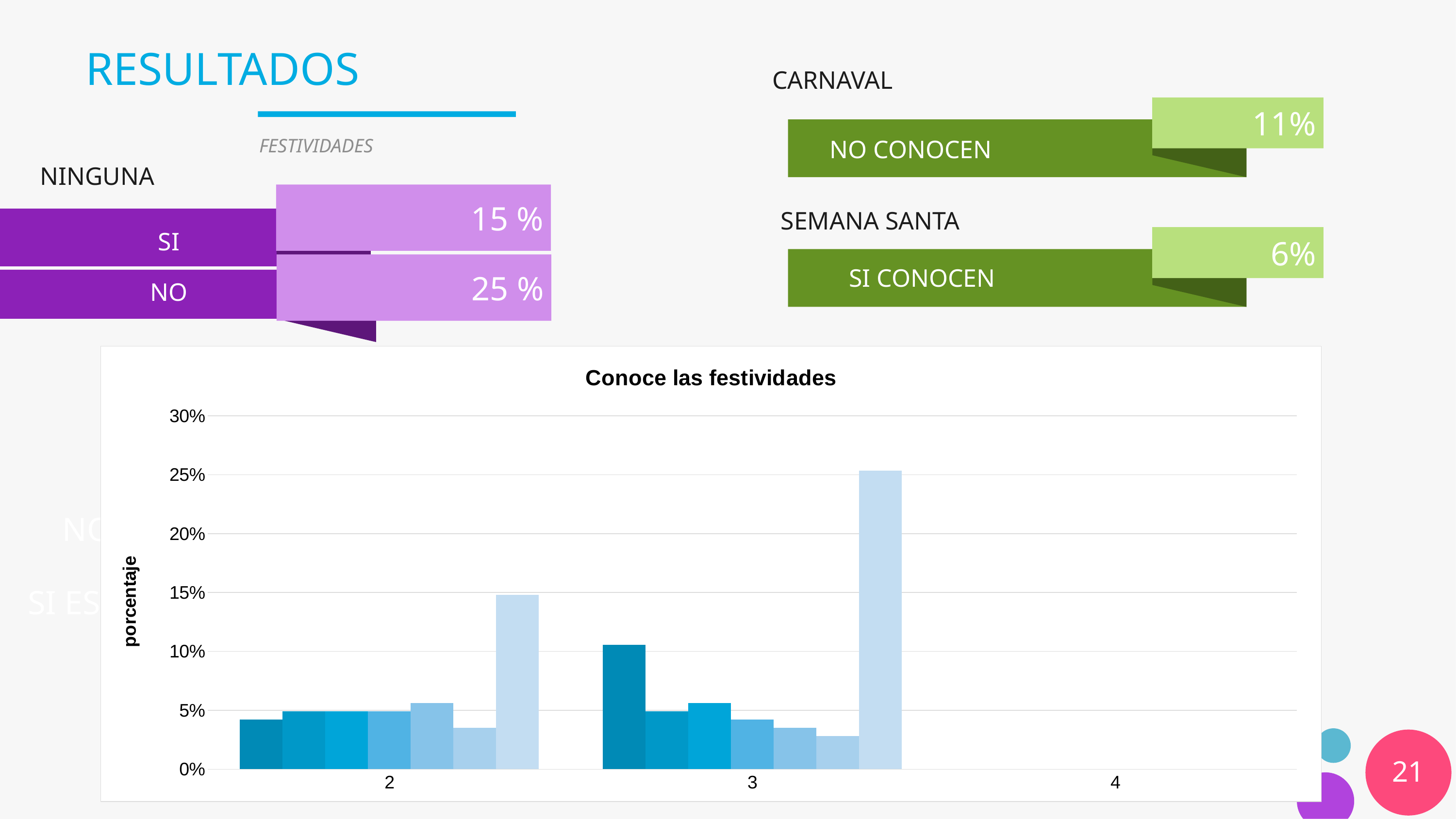
Which horizontal-axis category contains the tallest bar in the chart? 3 What is the label on the vertical axis of the chart? porcentaje Is the tallest bar in category 3 greater or less than 20%? greater What is the title of the chart on the slide? Conoce las festividades How many categories are labelled on the horizontal axis of the chart? 3 Is the first (darkest) bar in category 2 greater or less than 5%? less Is the tallest bar in category 2 greater or less than 10%? greater How many bars are plotted in category 2? 7 What kind of chart is shown on the slide? bar chart What is the highest value shown on the vertical axis of the chart? 30% Which is larger: the tallest bar in category 2 or the tallest bar in category 3? category 3